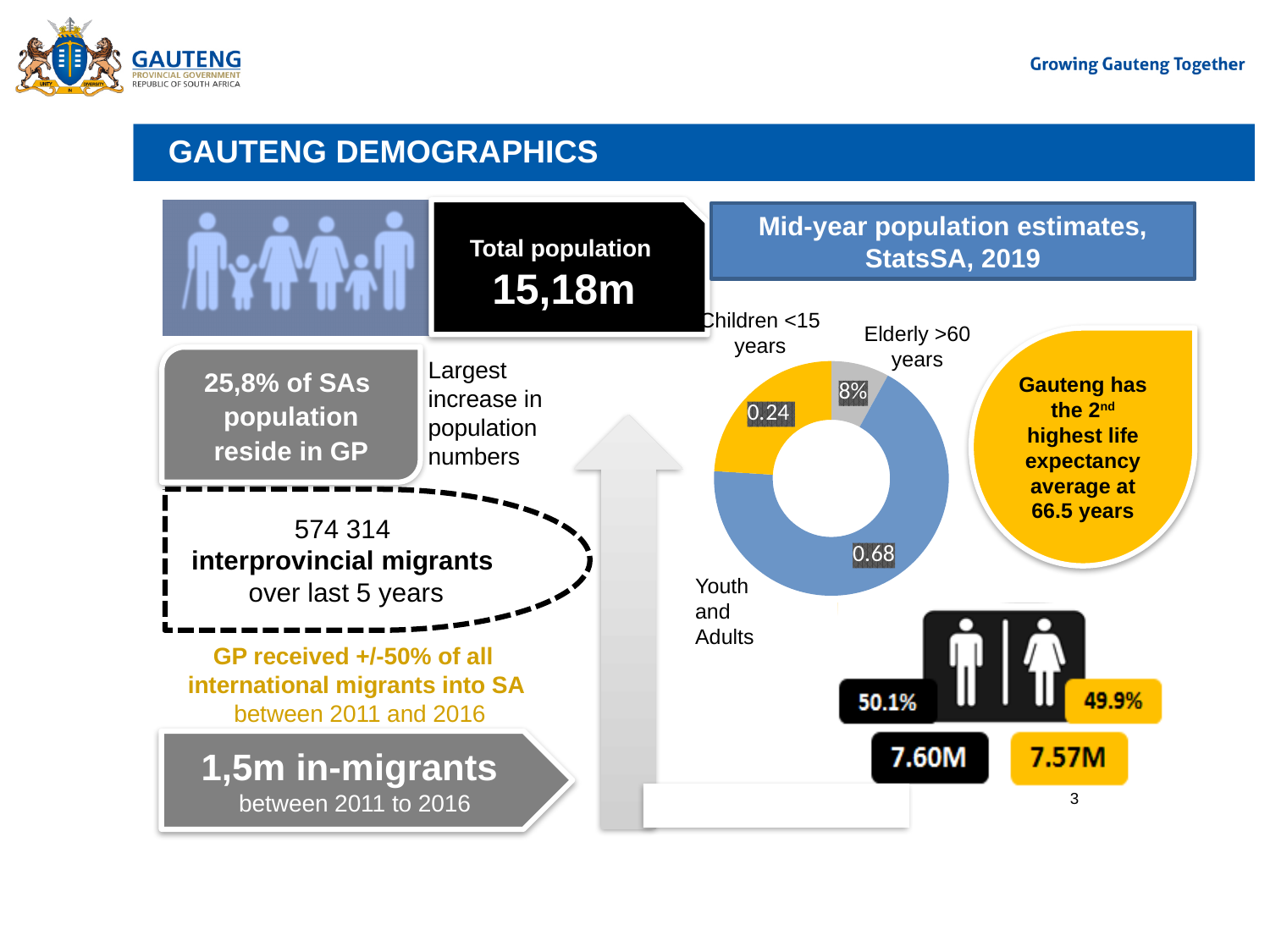
In the doughnut chart, which is larger: Children <15 years or Elderly >60 years? Children <15 years Which age category has the smallest share in the doughnut chart? Elderly >60 years Which age category has the largest share in the doughnut chart? Youth and Adults How many age categories does the doughnut chart show? 3 What value is shown for Youth and Adults in the doughnut chart? 0.68 What value is shown for Elderly >60 years in the doughnut chart? 8% In the doughnut chart, which is larger: Youth and Adults or Children <15 years? Youth and Adults What colour is the Children <15 years segment in the doughnut chart? Yellow What kind of chart is used to show the age breakdown of the population? Doughnut chart What value is shown for Children <15 years in the doughnut chart? 0.24 What colour is the Youth and Adults segment in the doughnut chart? Blue